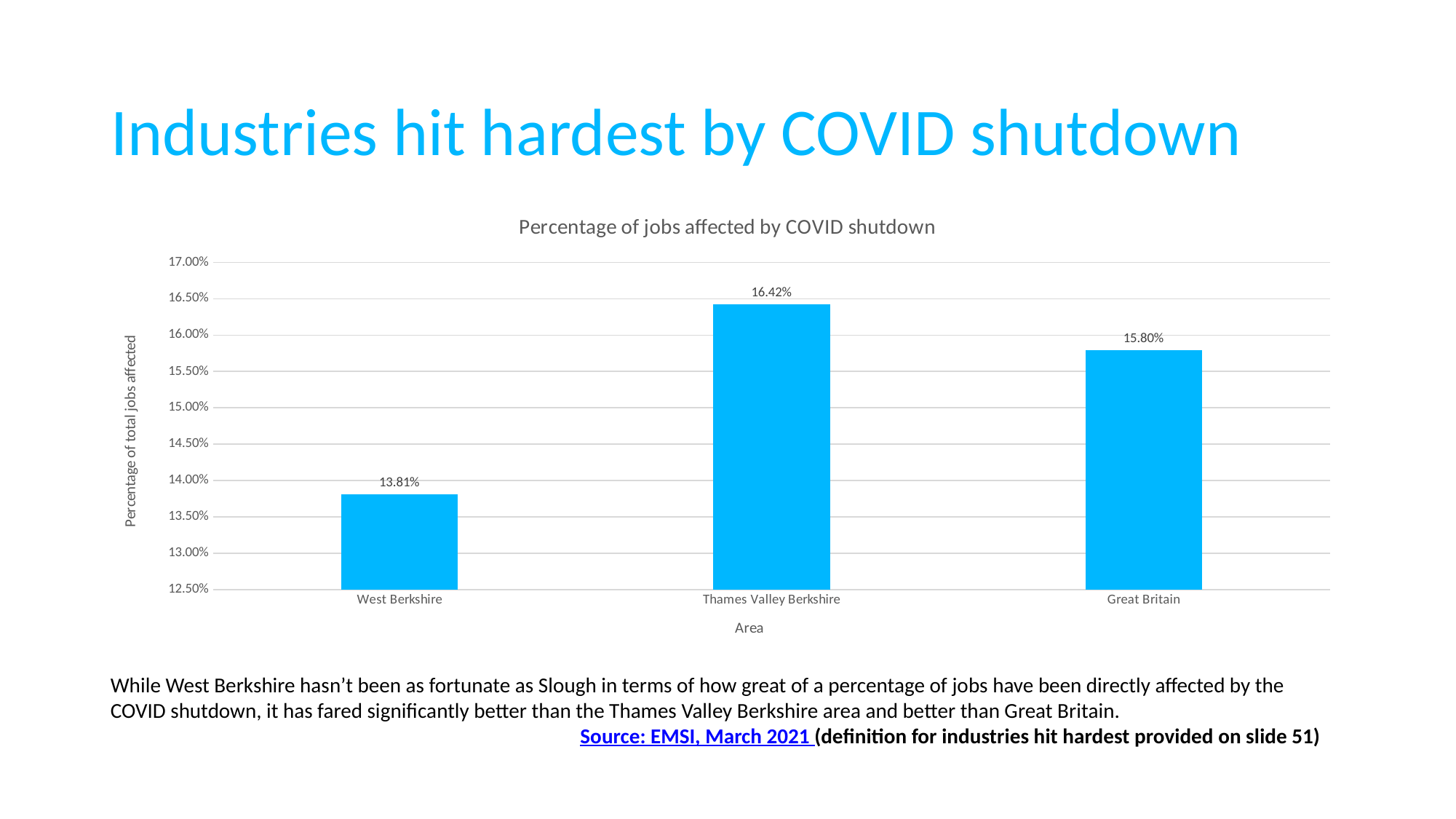
Which has a higher percentage of jobs affected, Great Britain or West Berkshire? Great Britain What is the percentage of jobs affected by COVID shutdown for West Berkshire? 13.81% What is the percentage of jobs affected by COVID shutdown for Thames Valley Berkshire? 16.42% Which area has the highest percentage of jobs affected by COVID shutdown? Thames Valley Berkshire Which area has the lowest percentage of jobs affected by COVID shutdown? West Berkshire What is the difference in percentage points between Thames Valley Berkshire and West Berkshire? 2.61% What is the title of the chart? Percentage of jobs affected by COVID shutdown How many areas are shown in the chart? 3 What is the percentage of jobs affected by COVID shutdown for Great Britain? 15.80% Is the value for West Berkshire greater or less than 14.00%? less What is the difference in percentage points between Thames Valley Berkshire and Great Britain? 0.62% What type of chart is shown on the slide? Bar chart